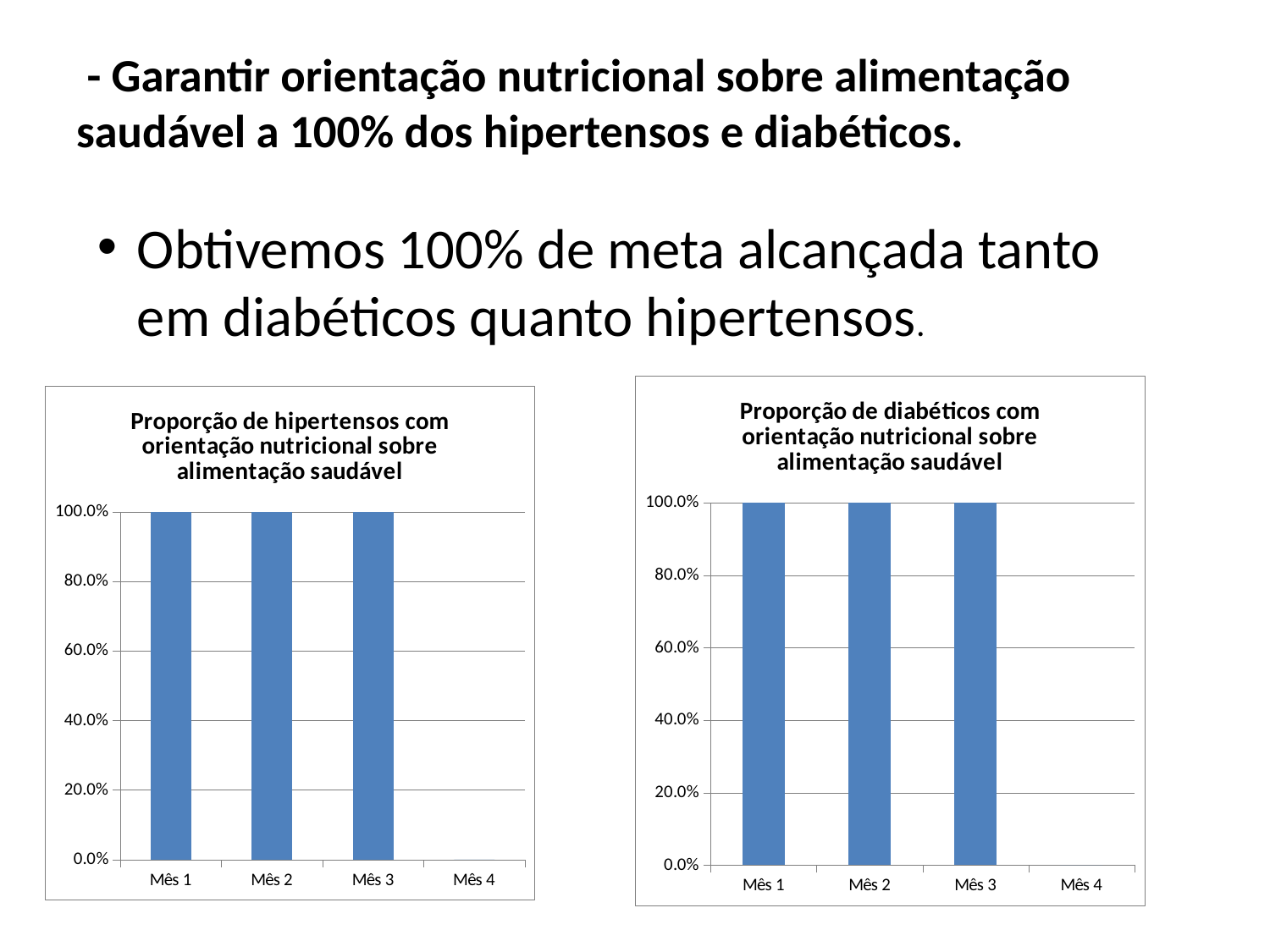
In the chart on the left, is the value for Mês 3 greater or less than 80.0%? greater In the chart on the right, which category has the lowest value? Mês 4 What kind of chart is the chart on the right? bar chart In the chart on the left, which category has the lowest value? Mês 4 In the chart titled 'Proporção de hipertensos com orientação nutricional sobre alimentação saudável', what is the value for Mês 1? 100.0% How many categories are shown on the x axis of the chart titled 'Proporção de hipertensos com orientação nutricional sobre alimentação saudável'? 4 In the chart titled 'Proporção de diabéticos com orientação nutricional sobre alimentação saudável', what is the value for Mês 3? 100.0% What is the title of the chart on the left? Proporção de hipertensos com orientação nutricional sobre alimentação saudável How many categories are shown on the x axis of the chart on the right? 4 In the chart titled 'Proporção de diabéticos com orientação nutricional sobre alimentação saudável', what is the difference between the values for Mês 1 and Mês 2? 0.0% In the chart on the left, what is the value for Mês 2? 100.0% In the chart on the right, is the value for Mês 1 greater or less than 60.0%? greater